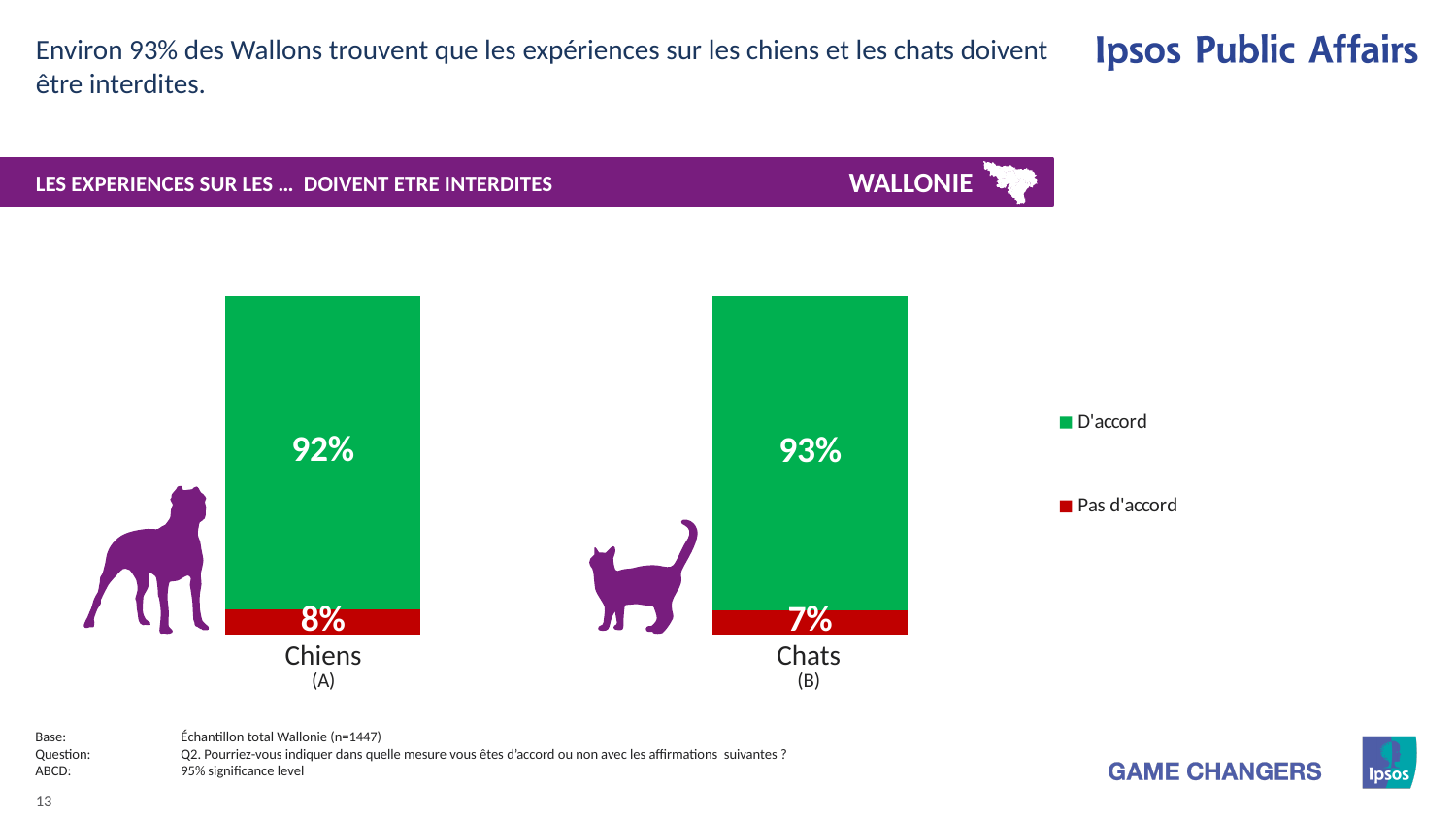
How many series does the legend list? 2 How many categories are shown on the x axis? 2 Which category has the lower "Pas d'accord" value? Chats What is the total of the stacked bar for Chiens? 100% What is the difference between the "D'accord" values for Chats and Chiens? 1% What is the "Pas d'accord" value for Chiens? 8% What is the "Pas d'accord" value for Chats? 7% What is the "D'accord" value for Chats? 93% What kind of chart is shown on the slide? Stacked bar chart What is the "D'accord" value for Chiens? 92% Is the "Pas d'accord" value for Chiens larger or smaller than the "Pas d'accord" value for Chats? larger Which category has the higher "D'accord" value? Chats